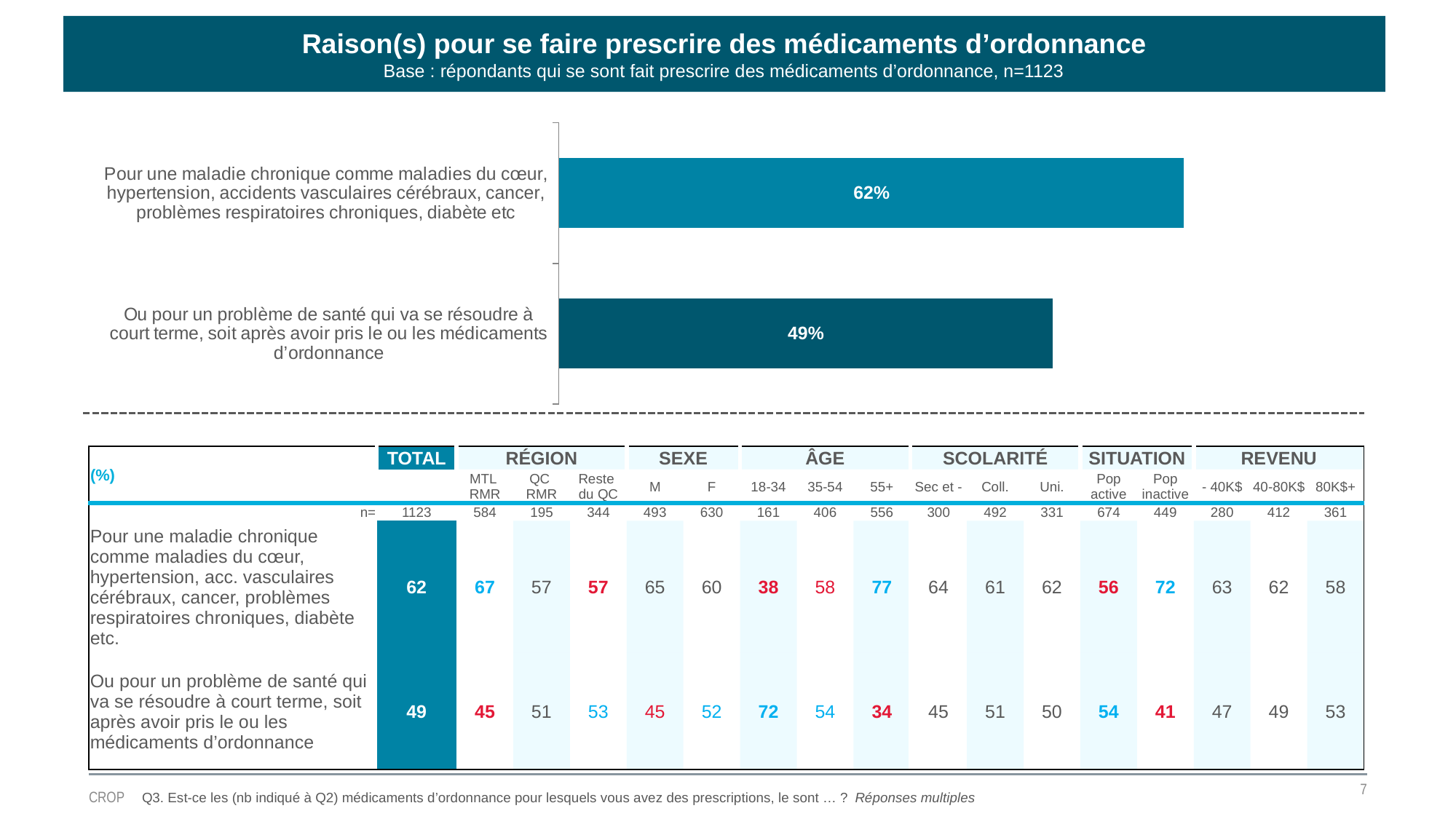
What is the difference in percentage points between the chronic illness reason and the short-term health problem reason? 13 What type of chart is shown on the slide? Bar chart Which reason has the lowest percentage in the bar chart? Ou pour un problème de santé qui va se résoudre à court terme, soit après avoir pris le ou les médicaments d'ordonnance Which reason has the highest percentage in the bar chart? Pour une maladie chronique comme maladies du cœur, hypertension, accidents vasculaires cérébraux, cancer, problèmes respiratoires chroniques, diabète etc What is the title of the chart on the slide? Raison(s) pour se faire prescrire des médicaments d'ordonnance How many reasons (bars) are shown in the bar chart? 2 Is the value for the chronic illness reason greater or less than 60%? greater Which is larger: the percentage for a chronic illness or the percentage for a short-term health problem? Chronic illness (62%) What percentage of respondents were prescribed medication for a chronic illness (maladie chronique)? 62% Is the value for the short-term health problem reason greater or less than 50%? less What percentage of respondents were prescribed medication for a short-term health problem (problème de santé qui va se résoudre à court terme)? 49% What is the base size (n) of respondents stated under the chart title? n=1123